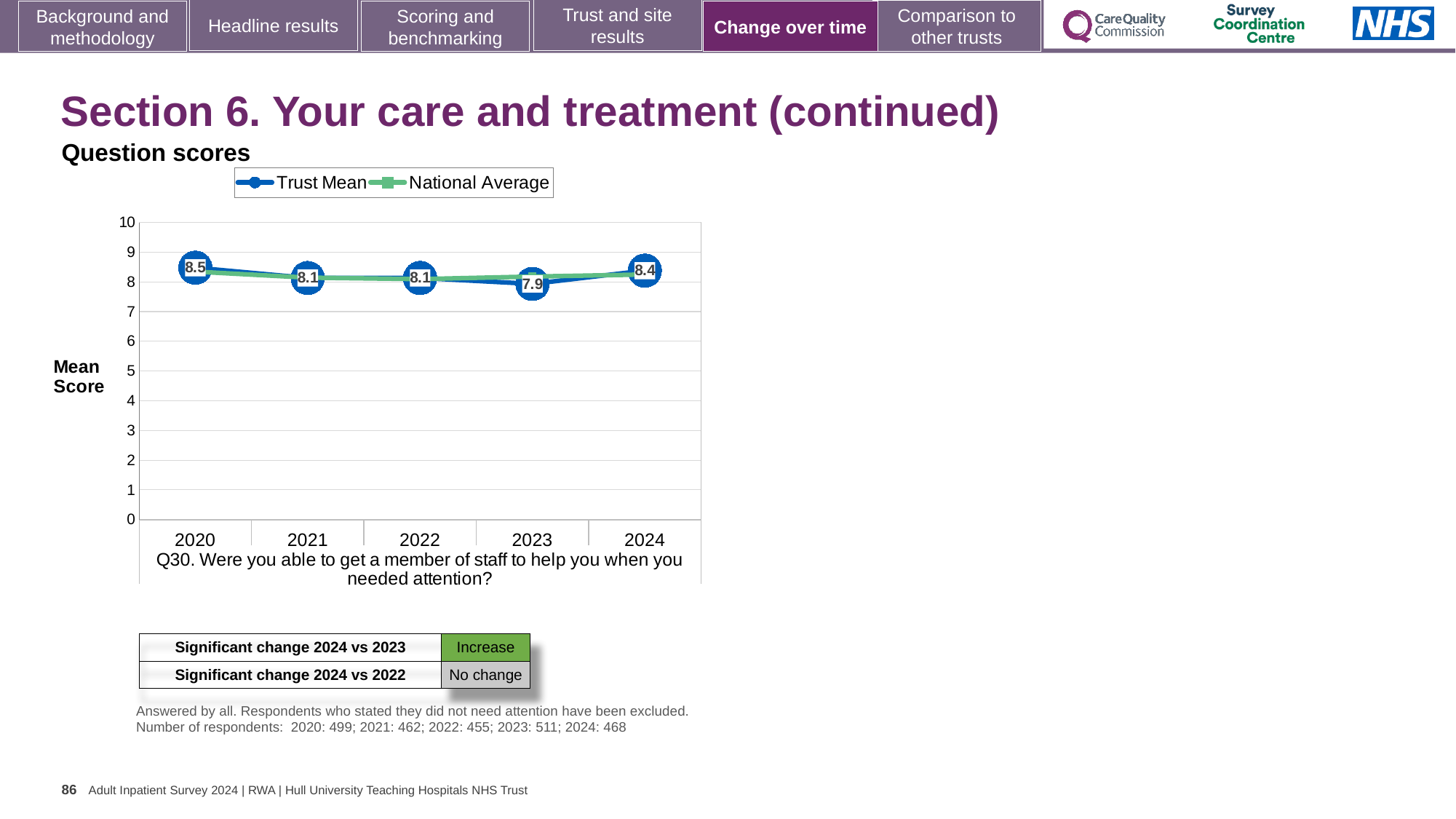
Is the Trust Mean score higher in 2020 or in 2021? 2020 Is the National Average value for 2023 greater or less than 7? greater What is the Trust Mean score for 2024? 8.4 How many series does the legend list? 2 Which year has the lowest Trust Mean score? 2023 Does the Trust Mean score rise or fall from 2023 to 2024? Rise What is the Trust Mean score for 2023? 7.9 What is the difference between the Trust Mean scores for 2024 and 2023? 0.5 What kind of chart is shown? Line chart What is the Trust Mean score for 2020? 8.5 Which year has the highest Trust Mean score? 2020 How many years are shown on the x axis? 5